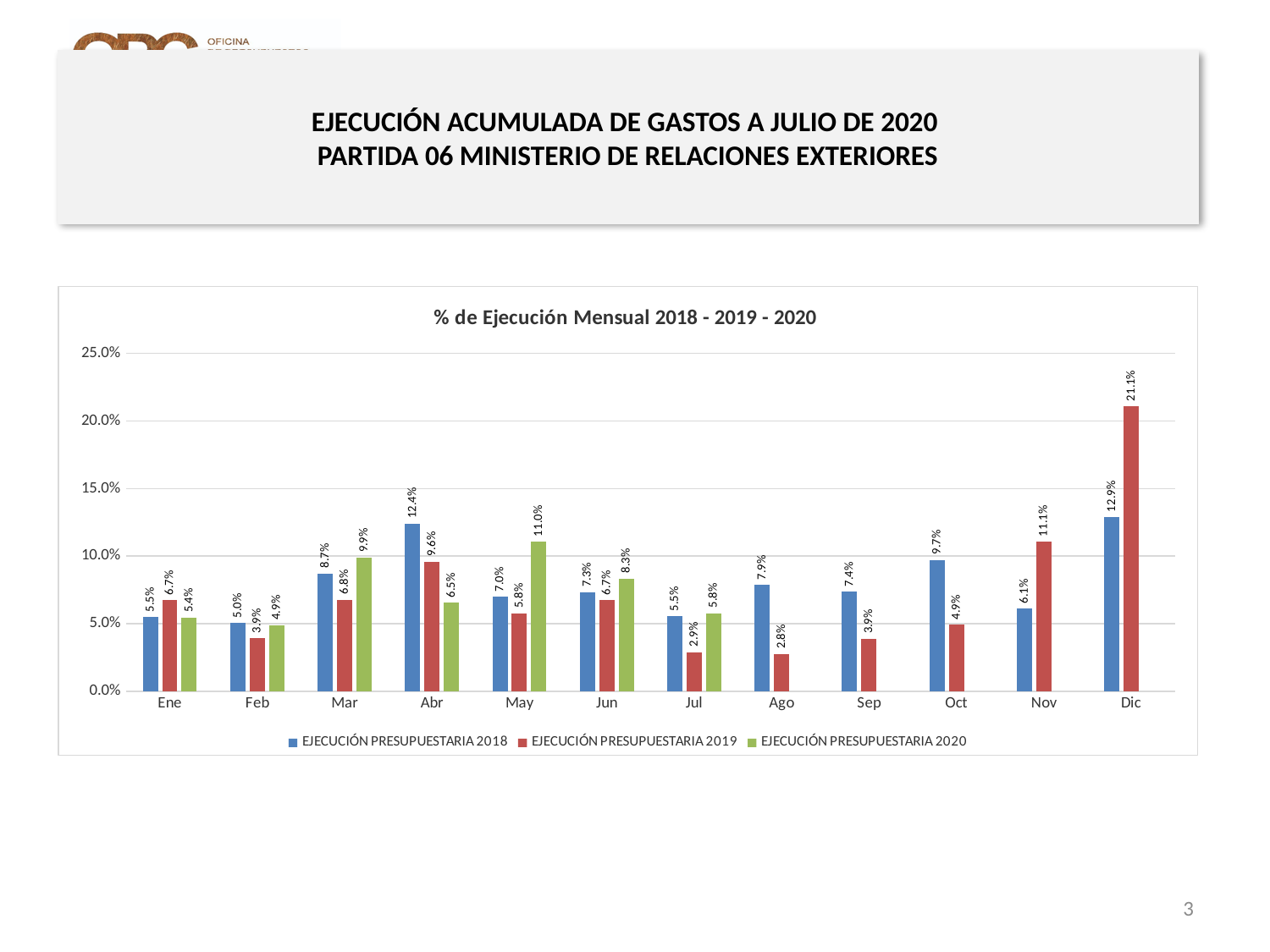
What is the value for EJECUCIÓN PRESUPUESTARIA 2018 in Abr? 12.4% Which month has the highest value for EJECUCIÓN PRESUPUESTARIA 2019? Dic In Mar, which is larger: EJECUCIÓN PRESUPUESTARIA 2018 or EJECUCIÓN PRESUPUESTARIA 2020? EJECUCIÓN PRESUPUESTARIA 2020 Which month has the lowest value for EJECUCIÓN PRESUPUESTARIA 2019? Ago How many series does the legend list? 3 What is the value for EJECUCIÓN PRESUPUESTARIA 2020 in May? 11.0% What is the title of the chart? % de Ejecución Mensual 2018 - 2019 - 2020 Which month has the highest value for EJECUCIÓN PRESUPUESTARIA 2020? May How many months are shown on the x axis? 12 What type of chart is shown on the slide? bar chart What is the value for EJECUCIÓN PRESUPUESTARIA 2019 in Dic? 21.1% What is the difference between EJECUCIÓN PRESUPUESTARIA 2019 and EJECUCIÓN PRESUPUESTARIA 2018 in Dic? 8.2%